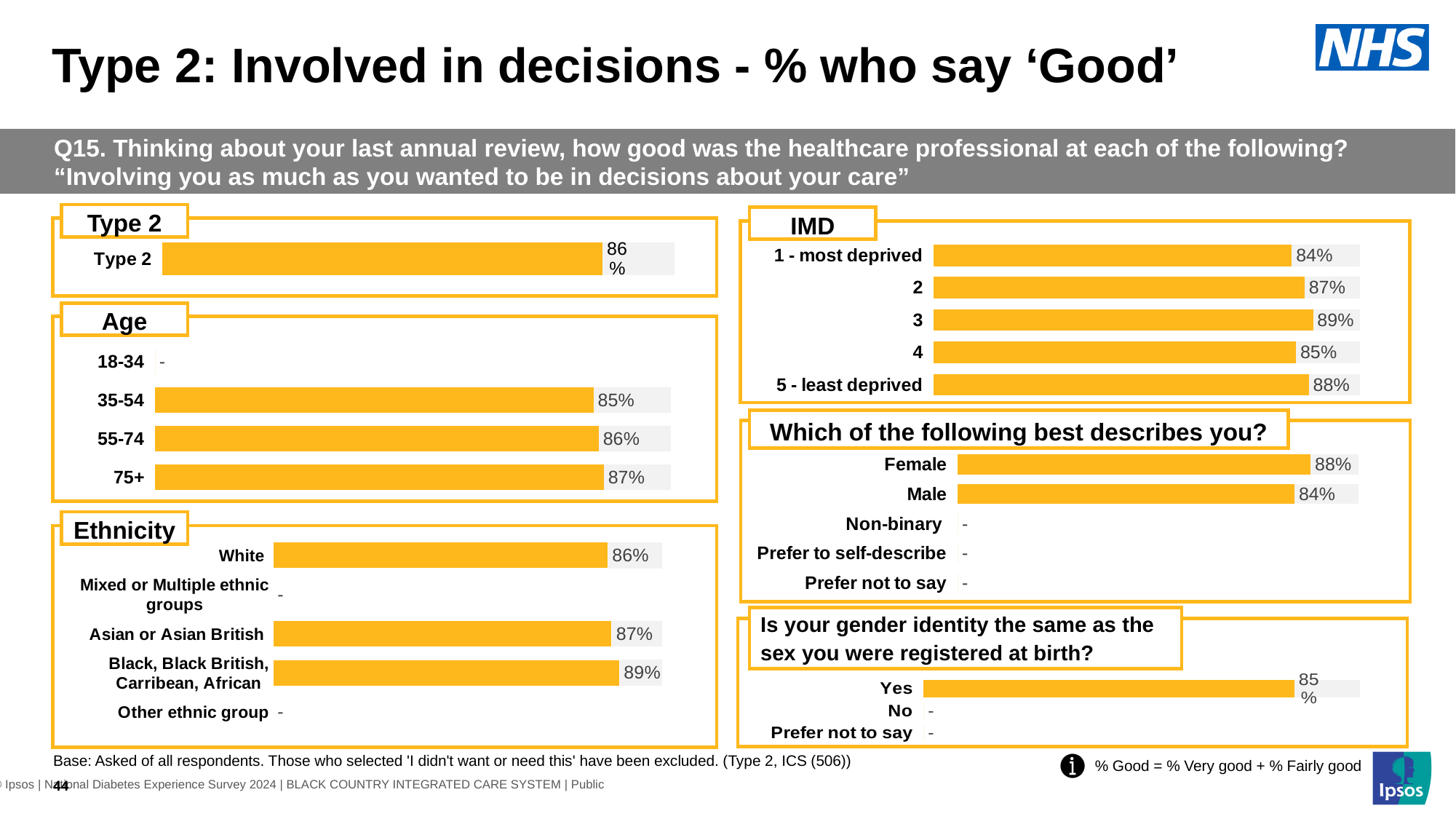
In the IMD chart, how many IMD categories are shown? 5 In the IMD chart, what is the value for 1 - most deprived? 84% In the Type 2 chart, what percentage of Type 2 respondents say 'Good'? 86% In the Ethnicity chart, which ethnic group has the highest percentage? Black, Black British, Carribean, African In the 'Which of the following best describes you?' chart, which is larger, Female or Male? Female In the Age chart, which age group with a plotted value has the lowest percentage? 35-54 In the IMD chart, which IMD group has the highest percentage? 3 What type of chart is used in the IMD section? Bar chart In the Ethnicity chart, what is the difference between the values for Asian or Asian British and White? 1% In the 'Is your gender identity the same as the sex you were registered at birth?' chart, what is the value for Yes? 85% In the 'Which of the following best describes you?' chart, what is the difference between Female and Male? 4% In the Age chart, what is the value for the 75+ age group? 87%